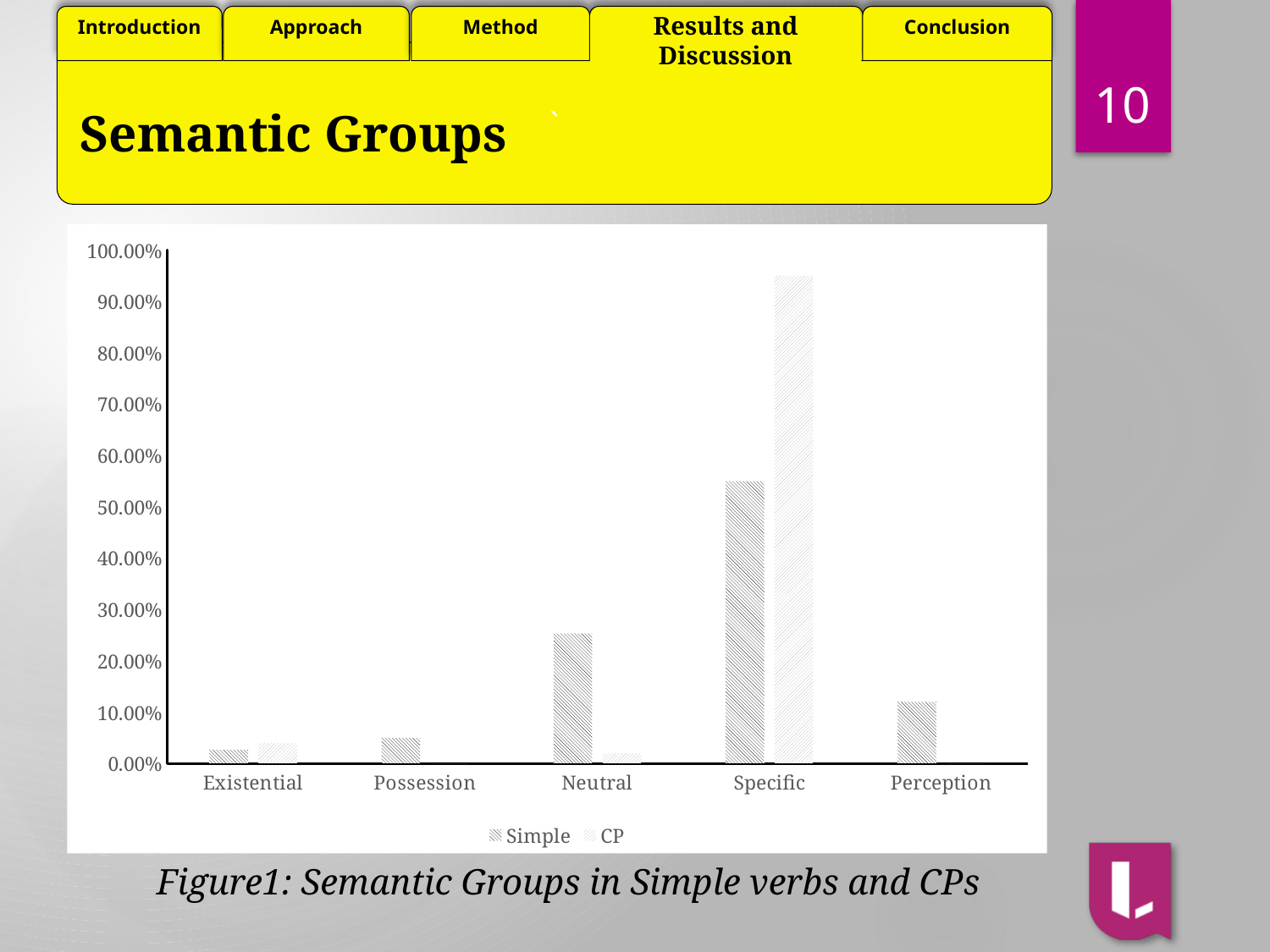
Is the Simple value for Existential greater or less than 10.00%? less Which category has the highest value for the Simple series? Specific Is the Simple value for Specific greater or less than 50.00%? greater How many series does the chart's legend list? 2 Which category has the highest value for the CP series? Specific What kind of chart is shown on the slide? bar chart For the Neutral category, which series has the larger value, Simple or CP? Simple How many categories are shown on the x axis of the chart? 5 Is the Simple value for Neutral greater or less than 20.00%? greater For the Specific category, which series has the larger value, Simple or CP? CP What are the two series named in the chart's legend? Simple and CP